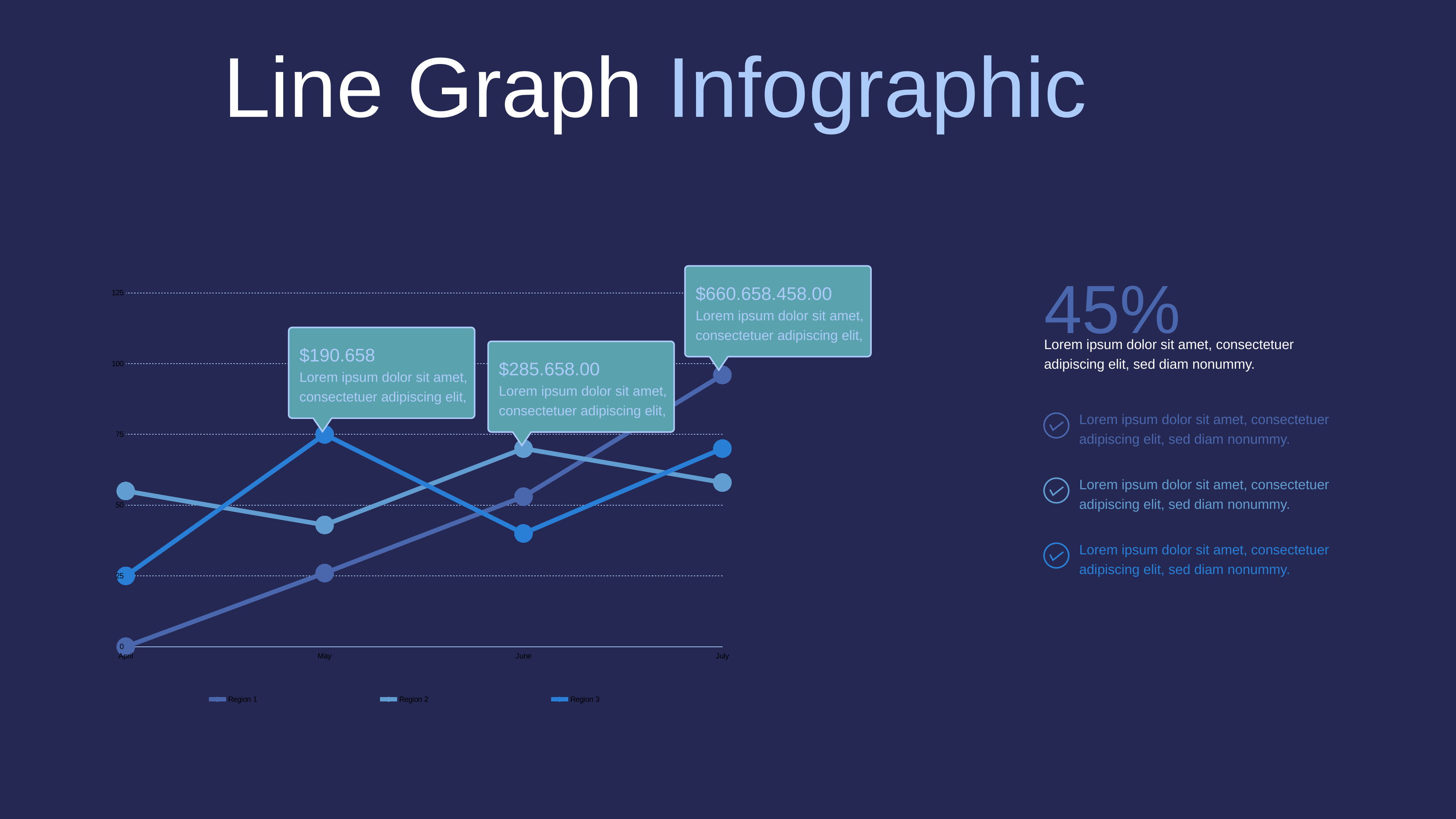
What is the value for Region 1 in April? 0 What is the value for Region 3 in April? 25 How many series does the legend list? 3 In which month is Region 1 at its highest? July Is the value for Region 3 in June greater or less than 50? less Is the value for Region 1 in July greater or less than 75? greater How many months are shown on the x axis? 4 Which is larger in May, Region 3 or Region 2? Region 3 What kind of chart is shown on the slide? line chart What is the value for Region 3 in May? 75 Do the values for Region 1 rise or fall from April to July? rise